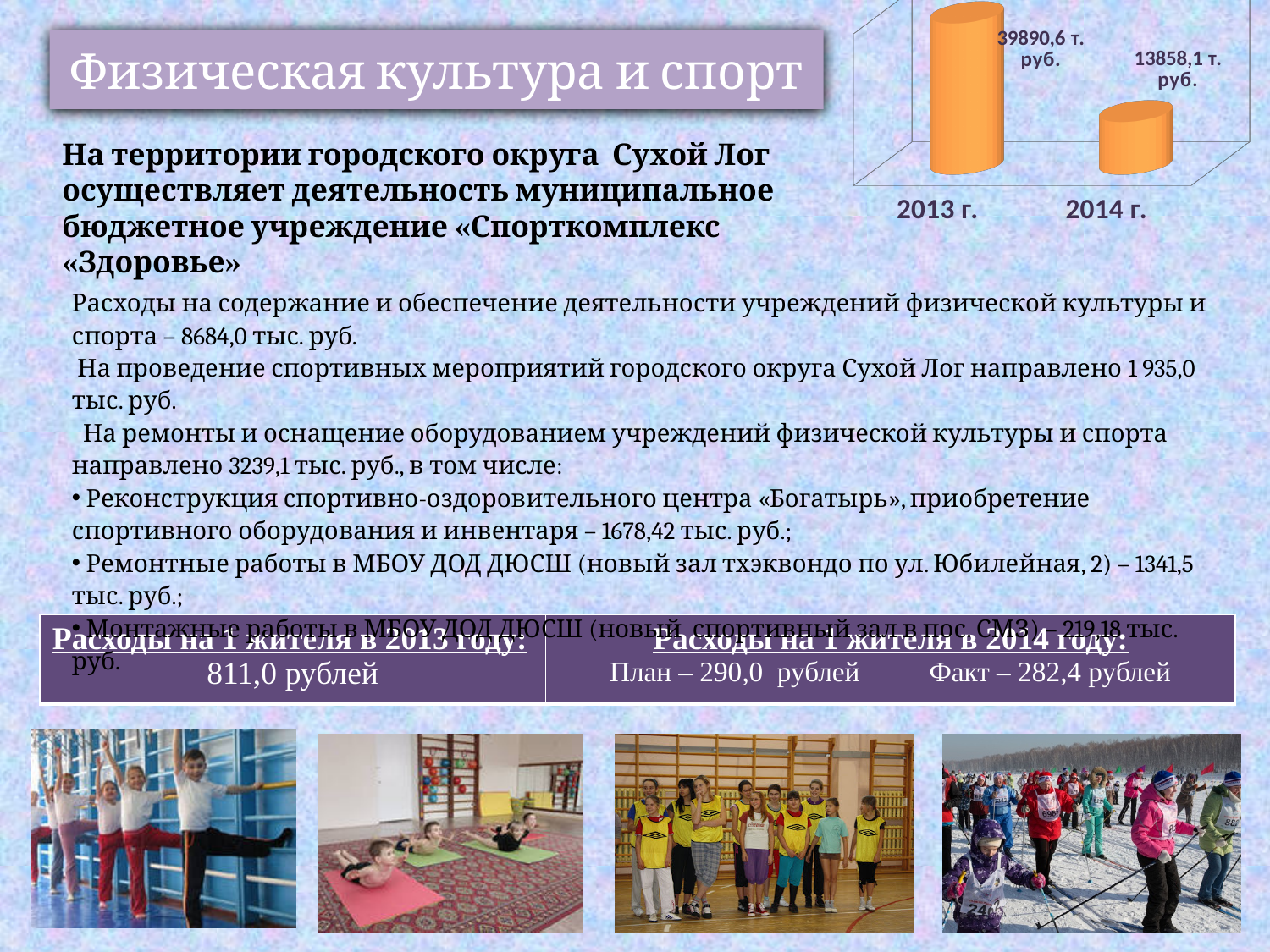
Which year has the lower value in the chart? 2014 г. What kind of chart is shown on the slide? bar chart Which years are labelled on the x axis of the chart? 2013 г. and 2014 г. Is the value for 2014 г. larger or smaller than the value for 2013 г.? smaller What is the value shown for 2013 г. in the chart? 39890,6 т. руб. What is the value shown for 2014 г. in the chart? 13858,1 т. руб. How many categories are plotted in the chart? 2 What colour are the bars in the chart? orange Do the values in the chart rise or fall from 2013 г. to 2014 г.? fall Which year has the higher value in the chart? 2013 г. By how much does the 2013 г. value exceed the 2014 г. value in the chart? 26032,5 т. руб.